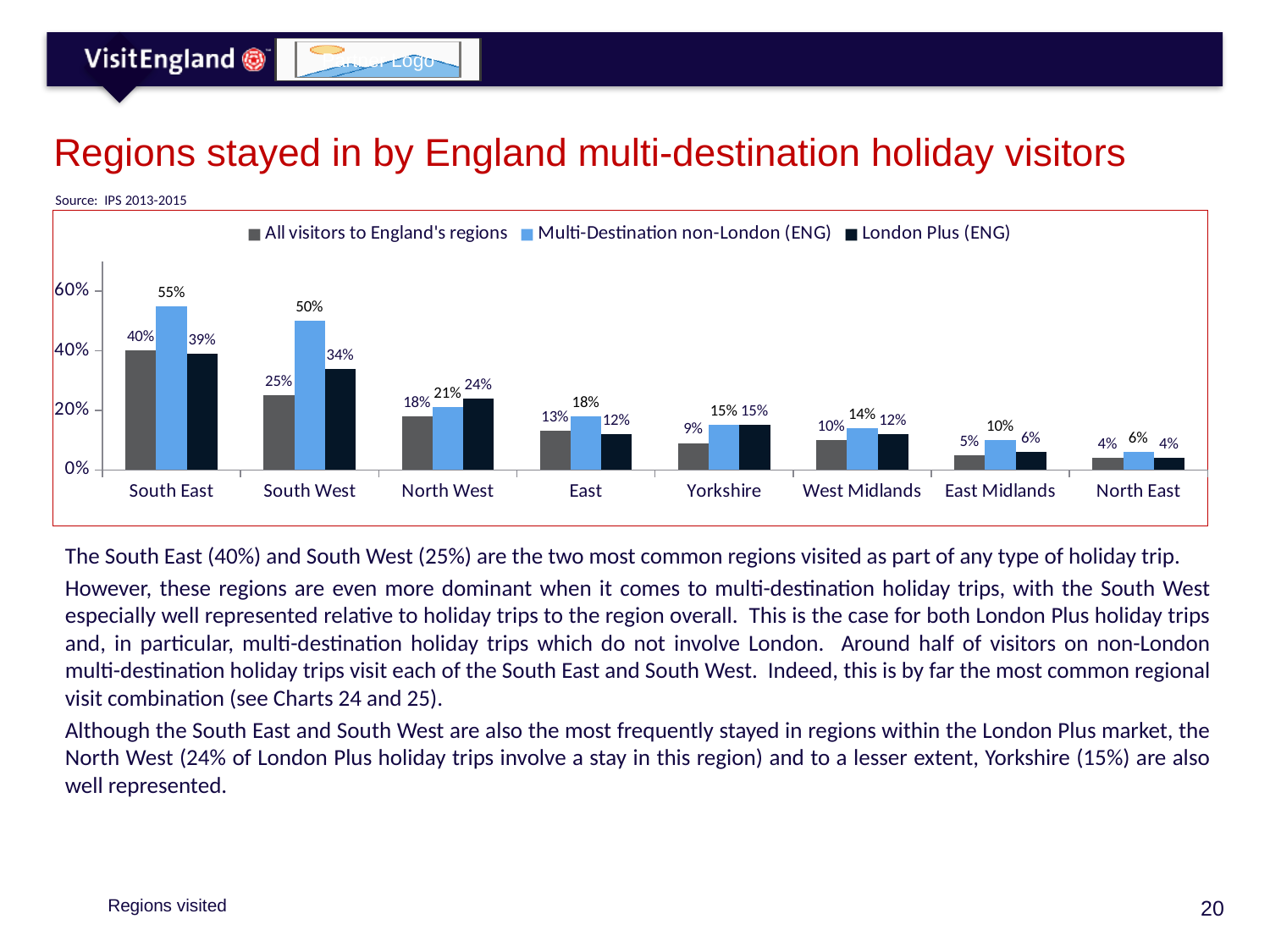
What is the source cited for the chart? IPS 2013-2015 Do the values for All visitors to England's regions rise or fall from South East to North East? Fall How many series does the legend list? 3 What is the difference between the Multi-Destination non-London (ENG) and All visitors to England's regions values in the South West? 25% What kind of chart is shown? Bar chart What is the value for All visitors to England's regions in the South West? 25% What is the value for Multi-Destination non-London (ENG) in the South East? 55% What is the value for London Plus (ENG) in the North West? 24% How many regions are shown on the x axis? 8 Which region has the highest value for Multi-Destination non-London (ENG)? South East Which region has the lowest value for All visitors to England's regions? North East Which is larger in the East: the Multi-Destination non-London (ENG) value or the London Plus (ENG) value? Multi-Destination non-London (ENG)